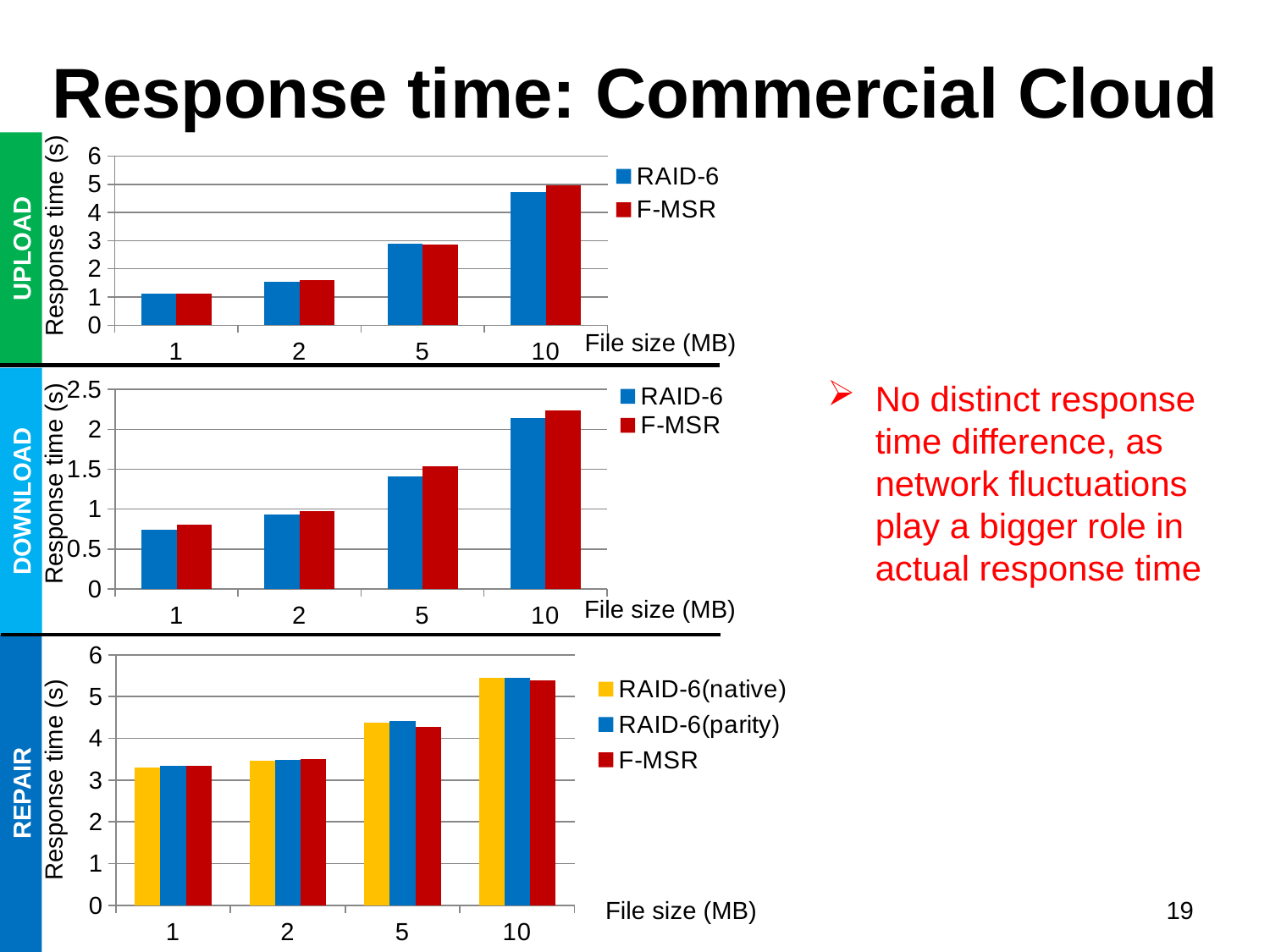
What kind of chart is the REPAIR chart? bar chart In the DOWNLOAD chart, is the RAID-6 value for file size 10 MB greater or less than 2? greater In the REPAIR chart, how many series does the legend list? 3 In the DOWNLOAD chart, how many file size categories are shown on the x axis? 4 In the REPAIR chart, is the F-MSR value for file size 1 MB greater or less than 3? greater In the REPAIR chart, is the RAID-6(native) value for file size 10 MB greater or less than 5? greater In the DOWNLOAD chart, which file size has the highest F-MSR response time? 10 In the UPLOAD chart, do the RAID-6 response times rise or fall as file size increases along the x axis? rise In the DOWNLOAD chart, at file size 5 MB, which series has the larger response time, RAID-6 or F-MSR? F-MSR In the UPLOAD chart, how many series does the legend list? 2